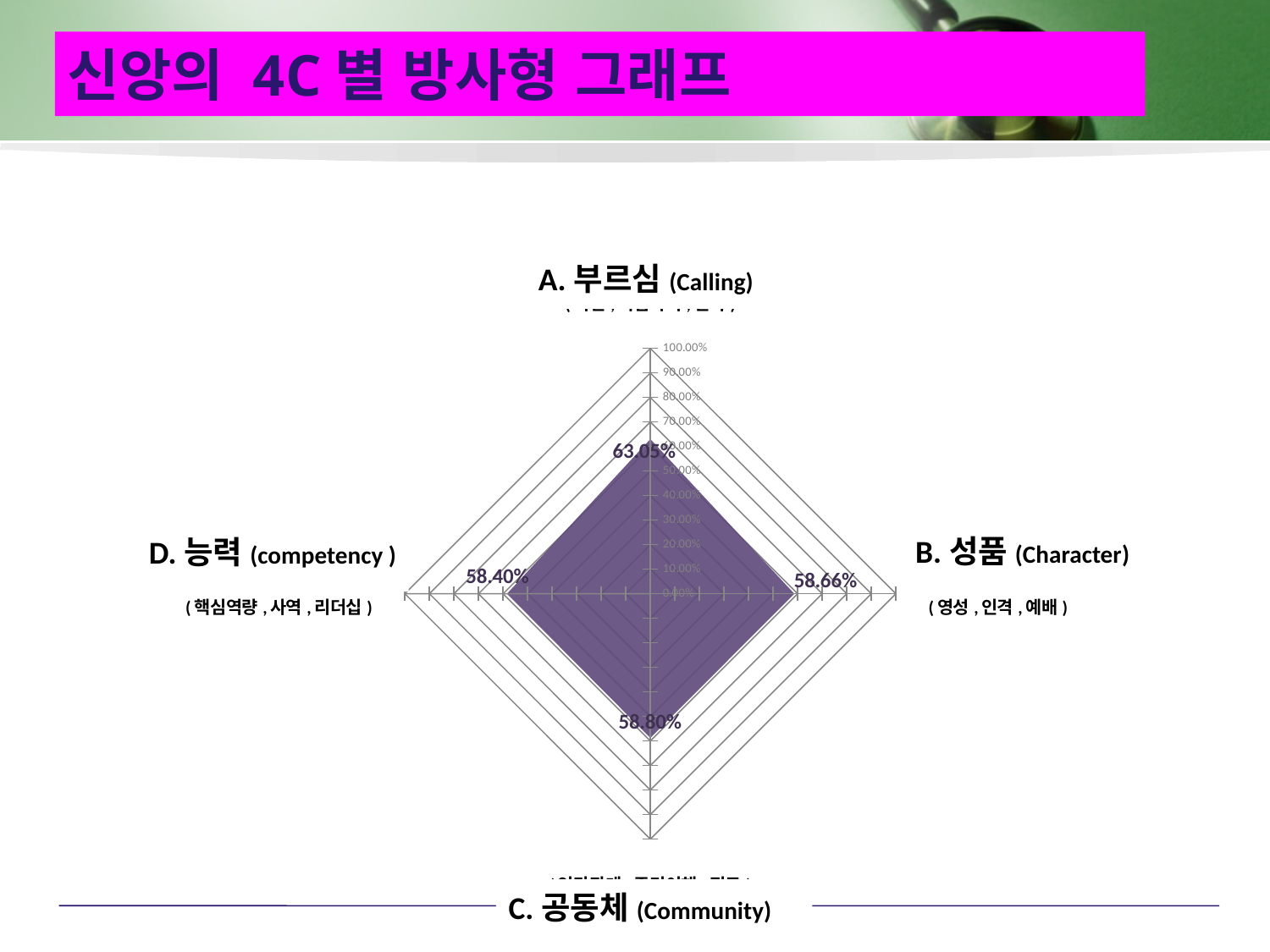
What is the difference between the values for A. 부르심 (Calling) and B. 성품 (Character)? 4.39% How many categories (axes) does the radar chart have? 4 What kind of chart is shown on the slide? Radar chart Which category has the lowest value? D. 능력 (competency) What is the value for D. 능력 (competency)? 58.40% What is the value for A. 부르심 (Calling)? 63.05% What is the value for C. 공동체 (Community)? 58.80% Is the value for A. 부르심 (Calling) greater or less than 60.00%? greater Which category has the highest value? A. 부르심 (Calling) What is the title of the slide containing the chart? 신앙의 4C 별 방사형 그래프 Which is larger, the value for C. 공동체 (Community) or D. 능력 (competency)? C. 공동체 (Community) What is the value for B. 성품 (Character)? 58.66%